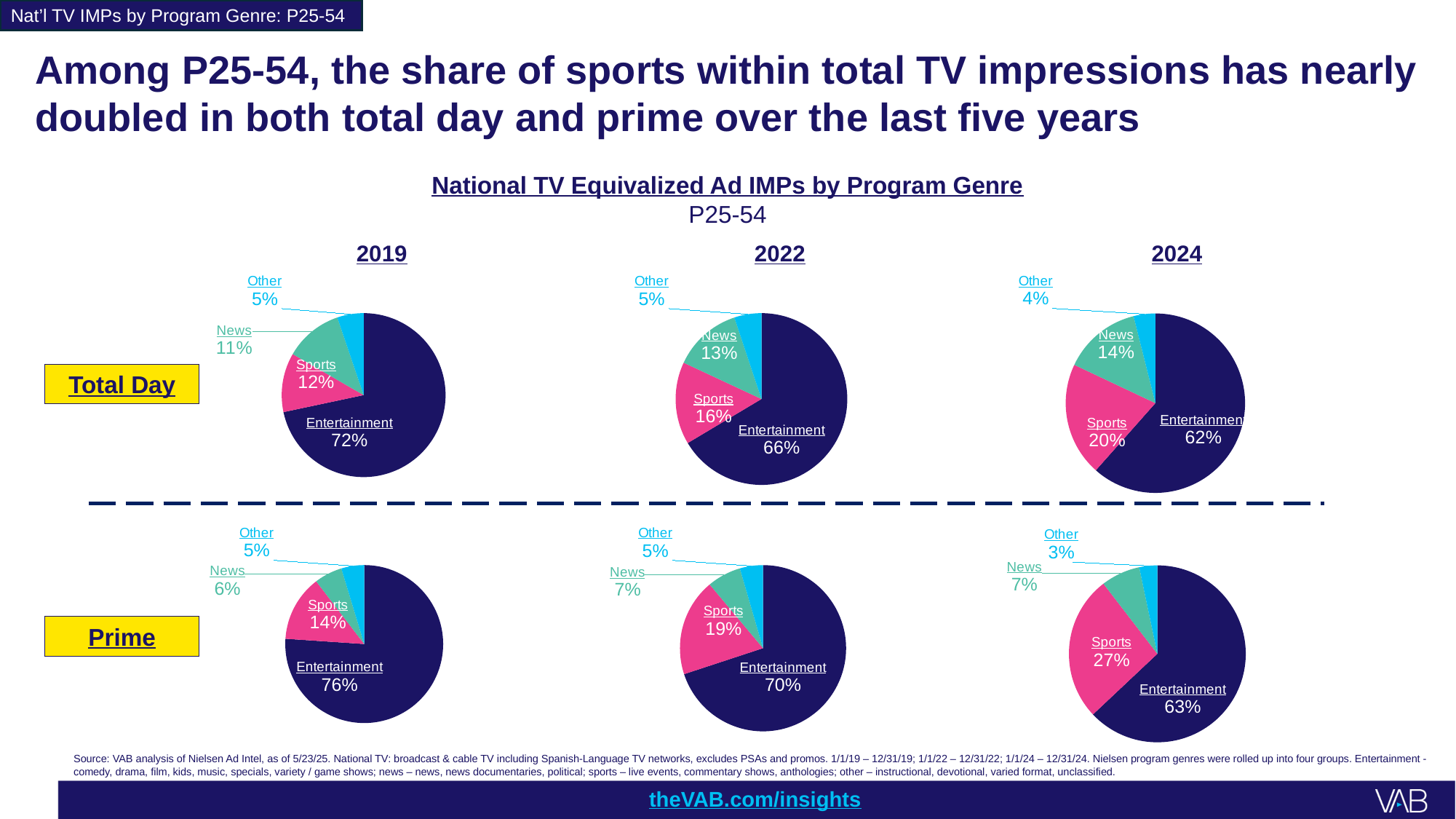
In the Prime 2024 pie chart, what share does Sports have? 27% What is the title shown above the pie charts? National TV Equivalized Ad IMPs by Program Genre Which is larger: the Sports share in the Total Day 2024 pie chart or the Sports share in the Prime 2022 pie chart? Total Day 2024 Across the Prime pie charts from 2019 to 2024, does the Entertainment share rise or fall? Fall In the Prime 2022 pie chart, what share does Other have? 5% How many genre slices does each pie chart on the slide have? 4 In the Total Day 2024 pie chart, what share does News have? 14% In the Prime 2024 pie chart, which genre has the smallest share? Other What type of chart is used on this slide? Pie chart In the Total Day 2022 pie chart, which genre has the largest share? Entertainment What is the difference between the Sports share in the Prime 2024 pie chart and the Sports share in the Prime 2019 pie chart? 13 percentage points In the Total Day 2019 pie chart, what share does Entertainment have? 72%